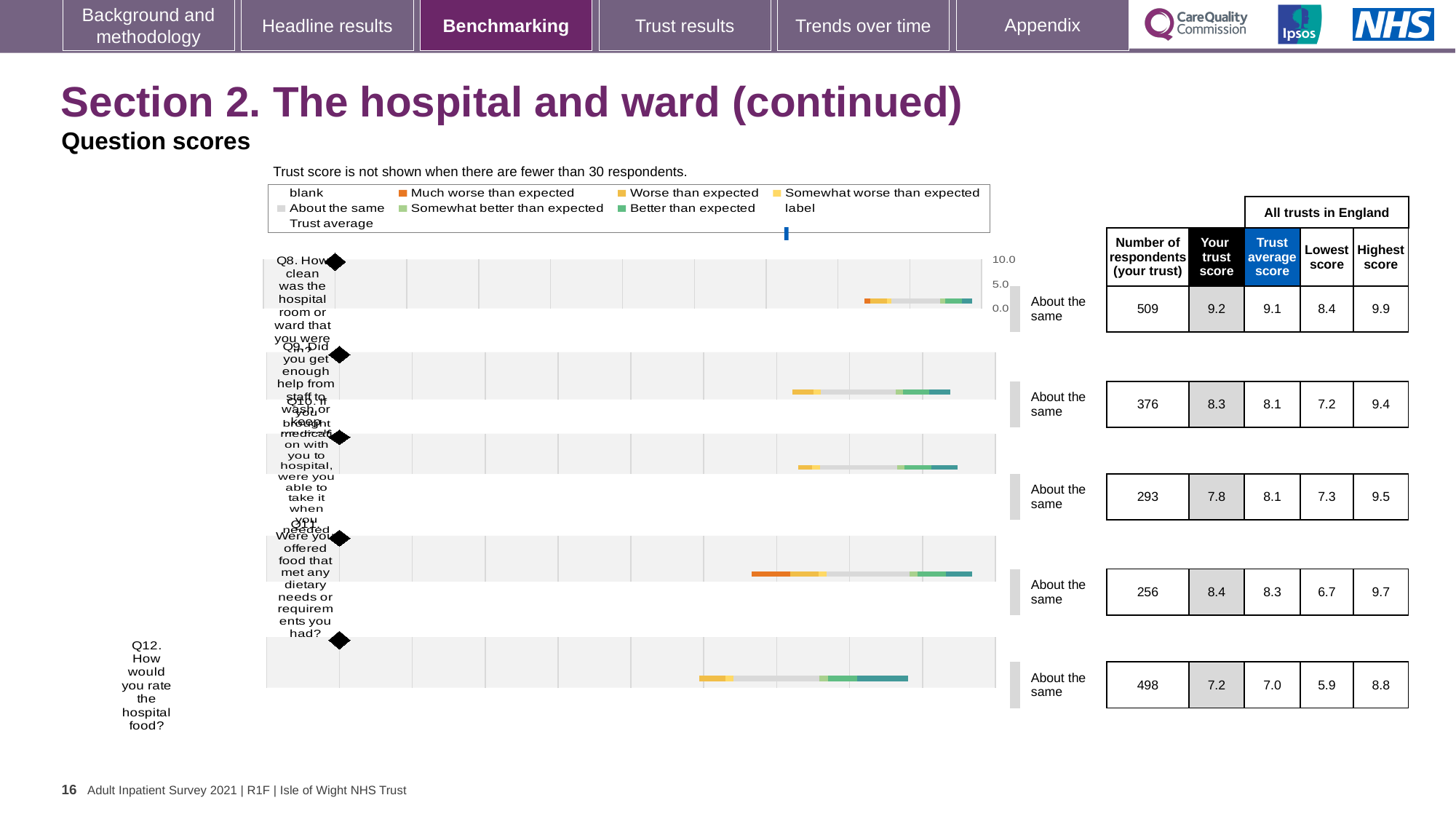
What kind of chart is used to show the question scores? Bar chart Is the number of respondents for Q10 greater or less than 300? less Which question has the lowest 'Your trust score'? Q12 What benchmark category is shown next to every question on the chart? About the same For Q12, what is the difference between the highest score (8.8) and the lowest score (5.9) across all trusts in England? 2.9 What is the 'Lowest score' across all trusts in England for Q11 (dietary needs or requirements)? 6.7 How many questions are plotted on the chart? 5 What is the 'Your trust score' for Q12 (How would you rate the hospital food?)? 7.2 How many respondents (your trust) are shown for Q8 (How clean was the hospital room or ward)? 509 Which question has the highest 'Your trust score'? Q8 For Q10, which is larger: the 'Your trust score' or the 'Trust average score'? Trust average score What is the 'Highest score' across all trusts in England for Q9 (enough help from staff to wash or keep yourself clean)? 9.4